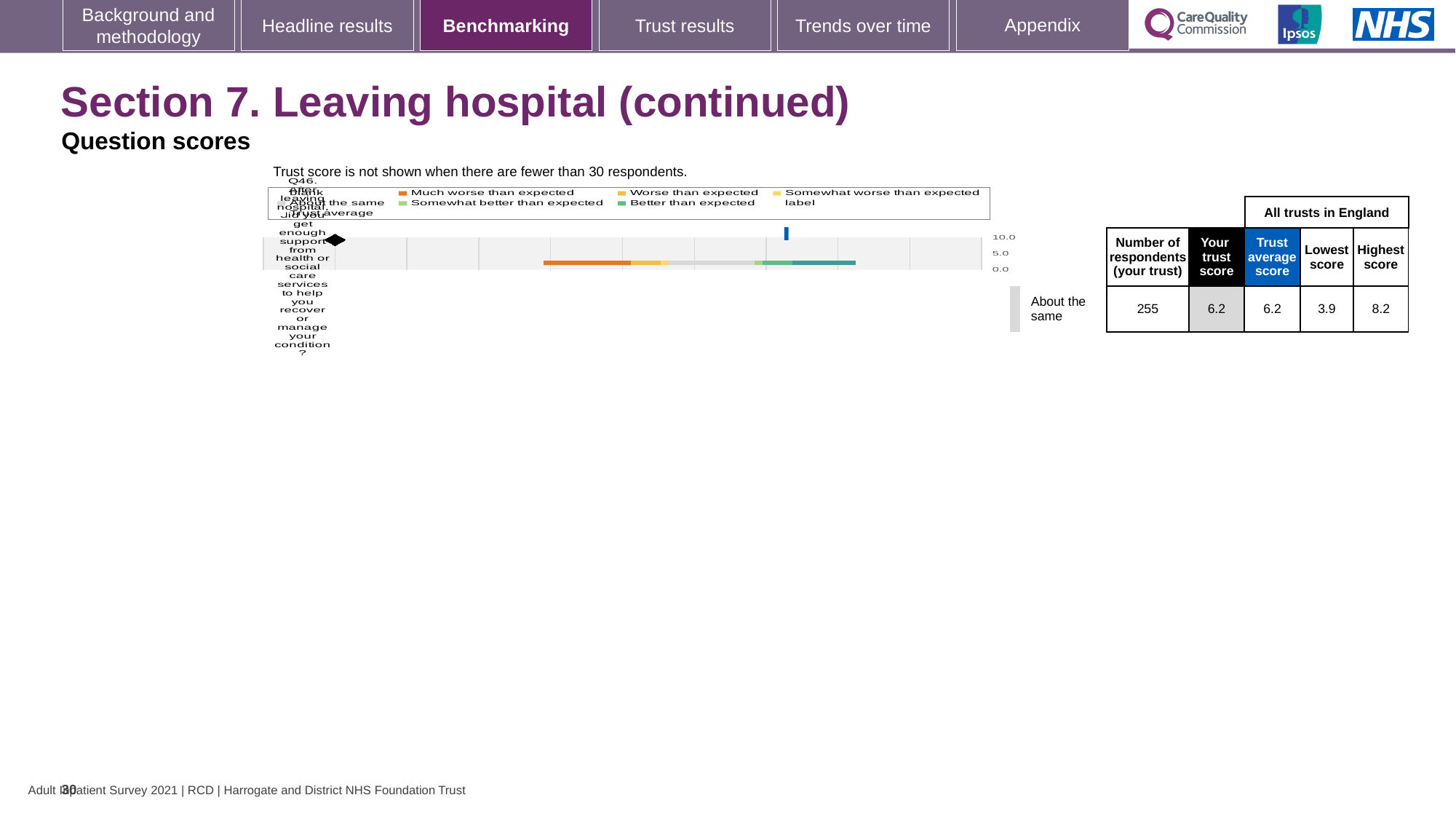
What is the highest score among all trusts in England for Q46? 8.2 What is the highest value shown on the chart's score axis? 10.0 What kind of chart is used to show the Q46 benchmarking result? bar chart What is the difference between the trust's score and the trust average score for Q46? 0.0 Which is larger for Q46: the trust's score or the lowest score in England? the trust's score What is the trust score for Q46 shown in the table next to the chart? 6.2 Is the trust's score for Q46 greater or less than 5.0 on the chart's axis? greater What is the trust average score for Q46 across all trusts in England? 6.2 What is the difference between the highest and lowest scores for Q46 across all trusts in England? 4.3 What is the lowest score among all trusts in England for Q46? 3.9 How many respondents from the trust answered Q46? 255 What benchmark category is the trust's Q46 result labelled as on the chart? About the same